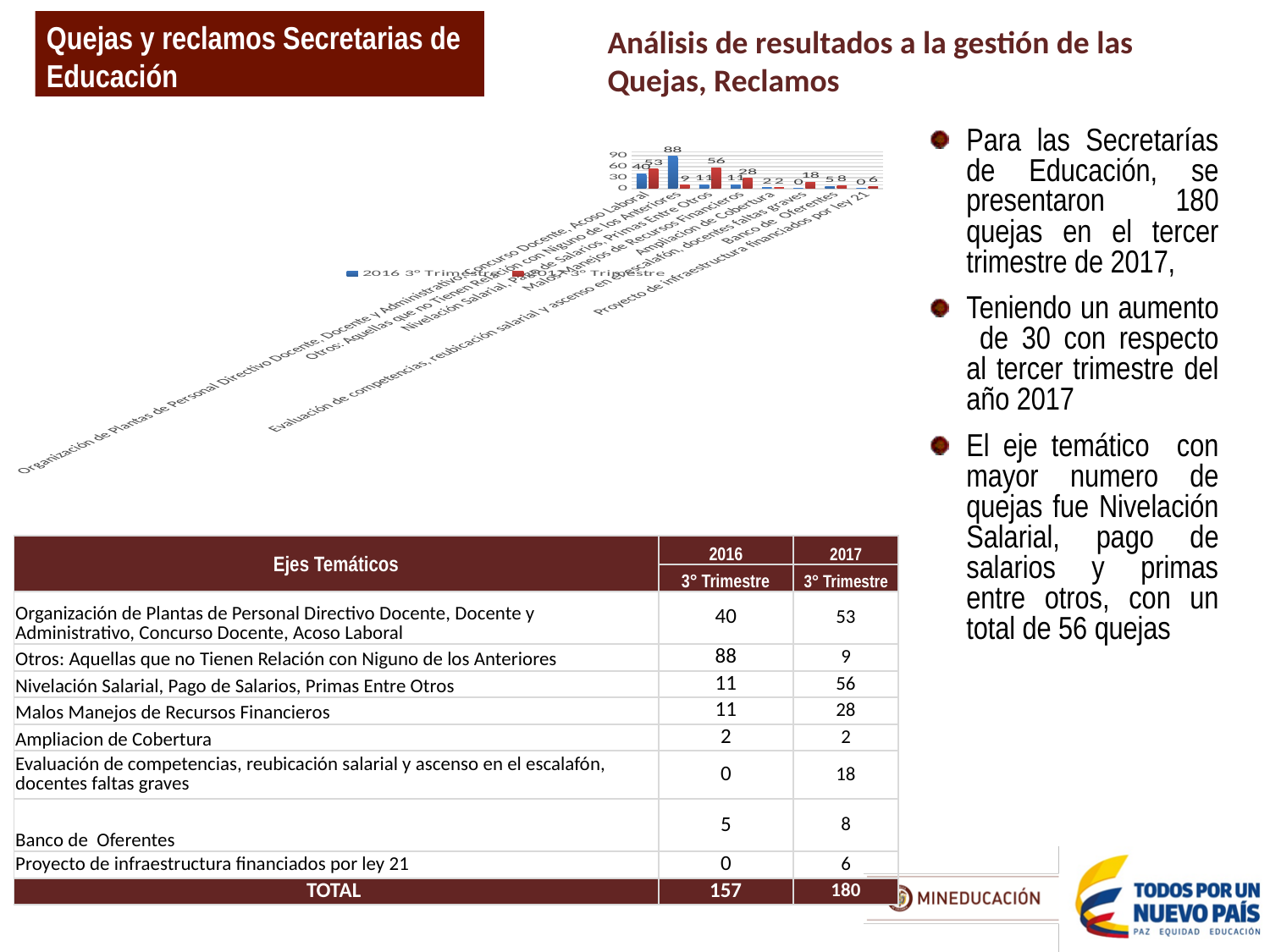
Which category has the highest value in the 2017 3° Trimestre series? Nivelación Salarial, Pago de Salarios, Primas Entre Otros What is the difference between the 2017 3° Trimestre and 2016 3° Trimestre values for Nivelación Salarial, Pago de Salarios, Primas Entre Otros? 45 Which category has the highest value in the 2016 3° Trimestre series? Otros: Aquellas que no Tienen Relación con Niguno de los Anteriores What are the two legend entries of the chart? 2016 3° Trimestre and 2017 3° Trimestre What is the value for Malos Manejos de Recursos Financieros in the 2017 3° Trimestre series? 28 Which is larger for Organización de Plantas de Personal Directivo Docente, Docente y Administrativo, Concurso Docente, Acoso Laboral: the 2016 3° Trimestre value or the 2017 3° Trimestre value? 2017 3° Trimestre What kind of chart is shown on the slide? bar chart How many series does the chart legend list? 2 How many categories are plotted on the chart? 8 What is the value for Nivelación Salarial, Pago de Salarios, Primas Entre Otros in the 2017 3° Trimestre series? 56 Is the 2016 3° Trimestre value for Otros: Aquellas que no Tienen Relación con Niguno de los Anteriores greater or less than 60? greater What is the value for Otros: Aquellas que no Tienen Relación con Niguno de los Anteriores in the 2016 3° Trimestre series? 88